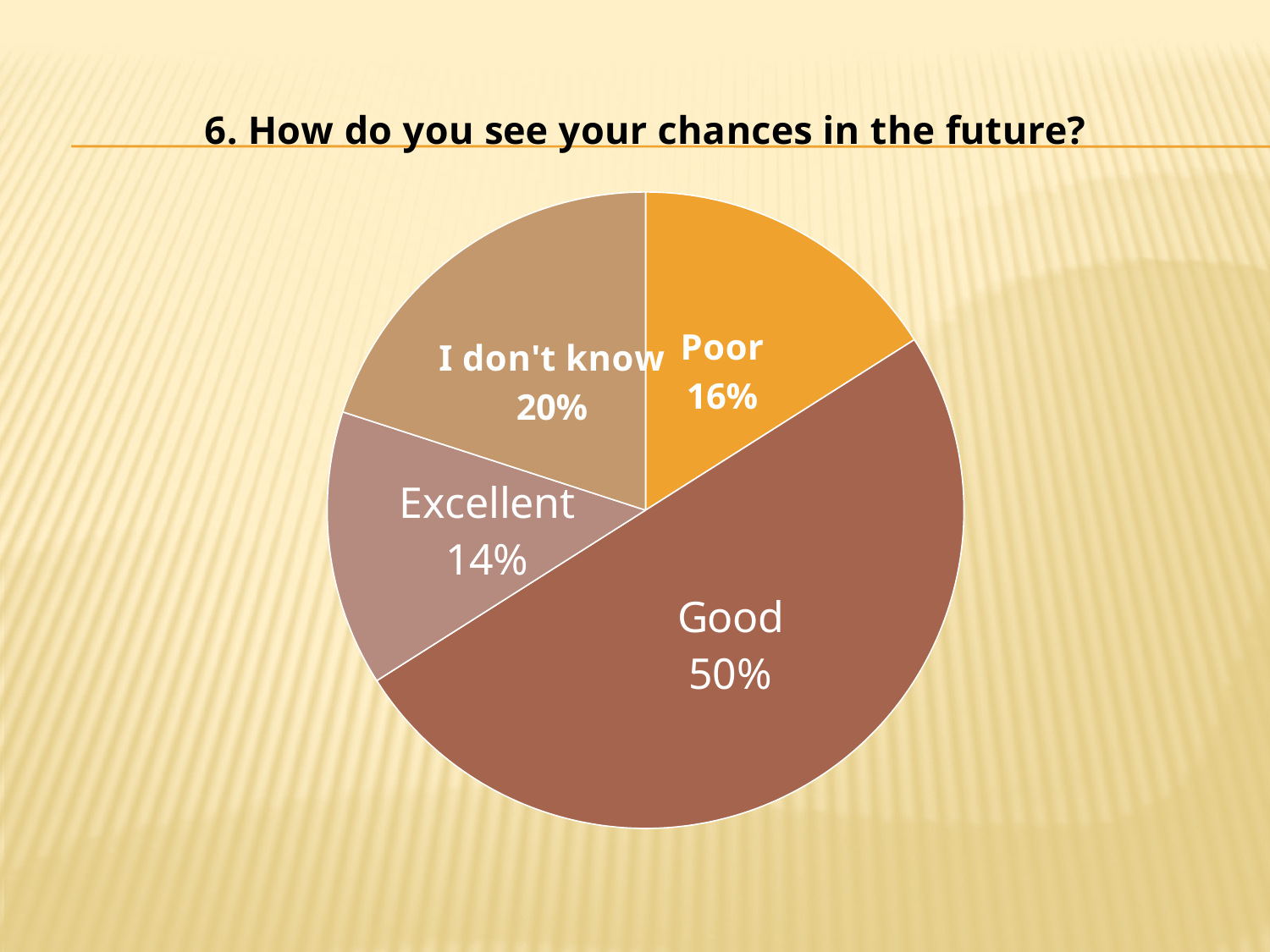
Which is larger, the share for "Poor" or the share for "Excellent"? Poor How many slices does the pie chart have? 4 What is the title of the slide? 6. How do you see your chances in the future? What percentage of respondents answered "Excellent"? 14% What percentage of respondents answered "Good"? 50% Which response has the largest share of the pie? Good What percentage of respondents answered "Poor"? 16% What is the difference in percentage points between "Good" and "I don't know"? 30 What percentage of respondents answered "I don't know"? 20% Which response has the smallest share of the pie? Excellent What kind of chart is shown on the slide? pie chart What colour is the "Poor" slice? orange